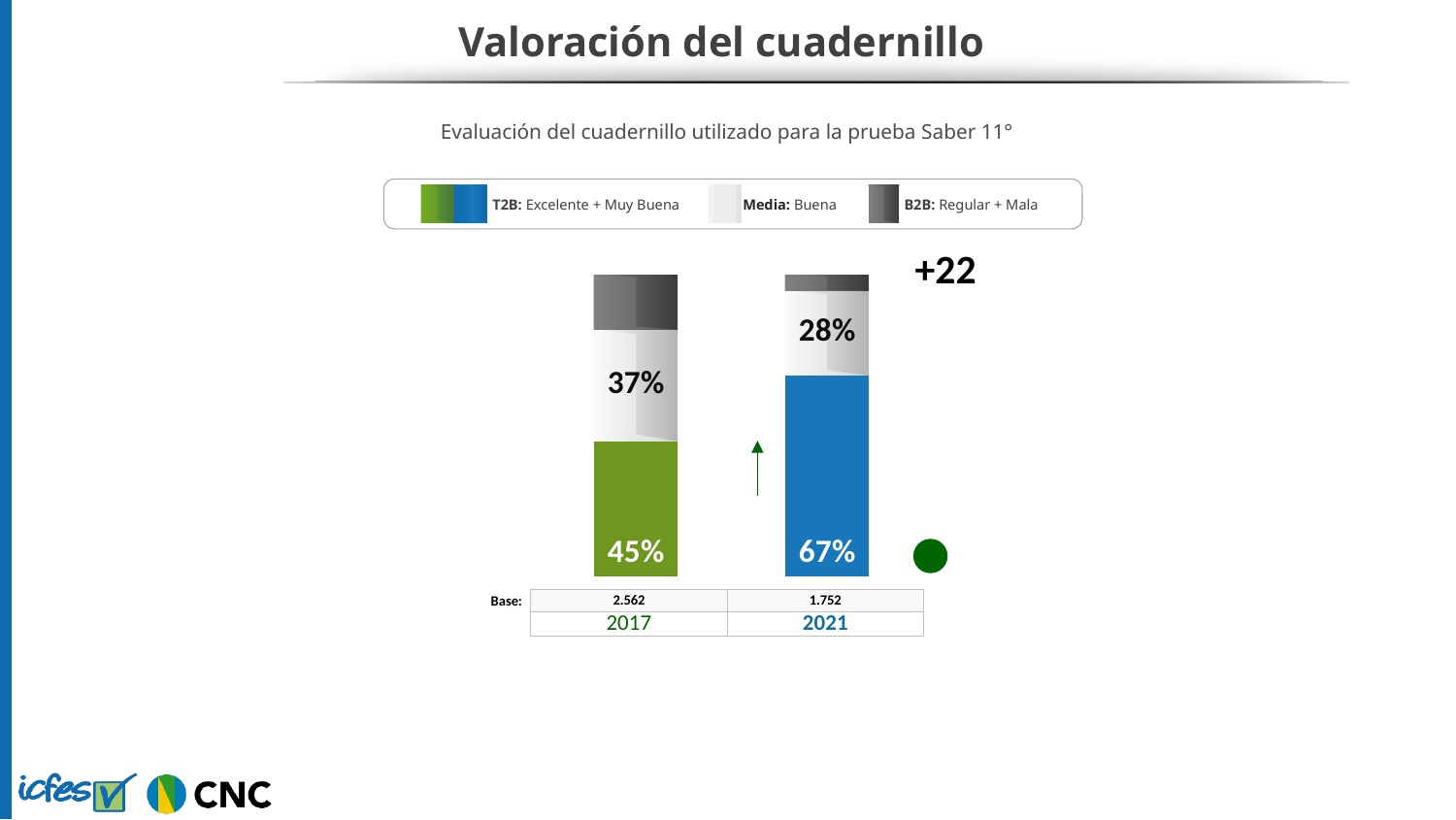
What is the difference between the T2B values for 2021 and 2017? 22 How many series does the legend list? 3 Which year has the higher T2B (Excelente + Muy Buena) value? 2021 What is the T2B (Excelente + Muy Buena) value for 2017? 45% How many years (categories) are shown on the x axis? 2 What is the base (sample size) shown for 2021? 1.752 What is the base (sample size) shown for 2017? 2.562 What is the Media (Buena) value for 2017? 37% What is the Media (Buena) value for 2021? 28% What is the T2B (Excelente + Muy Buena) value for 2021? 67% What kind of chart is shown on the slide? Stacked bar chart Is the Media (Buena) value larger in 2017 or in 2021? 2017